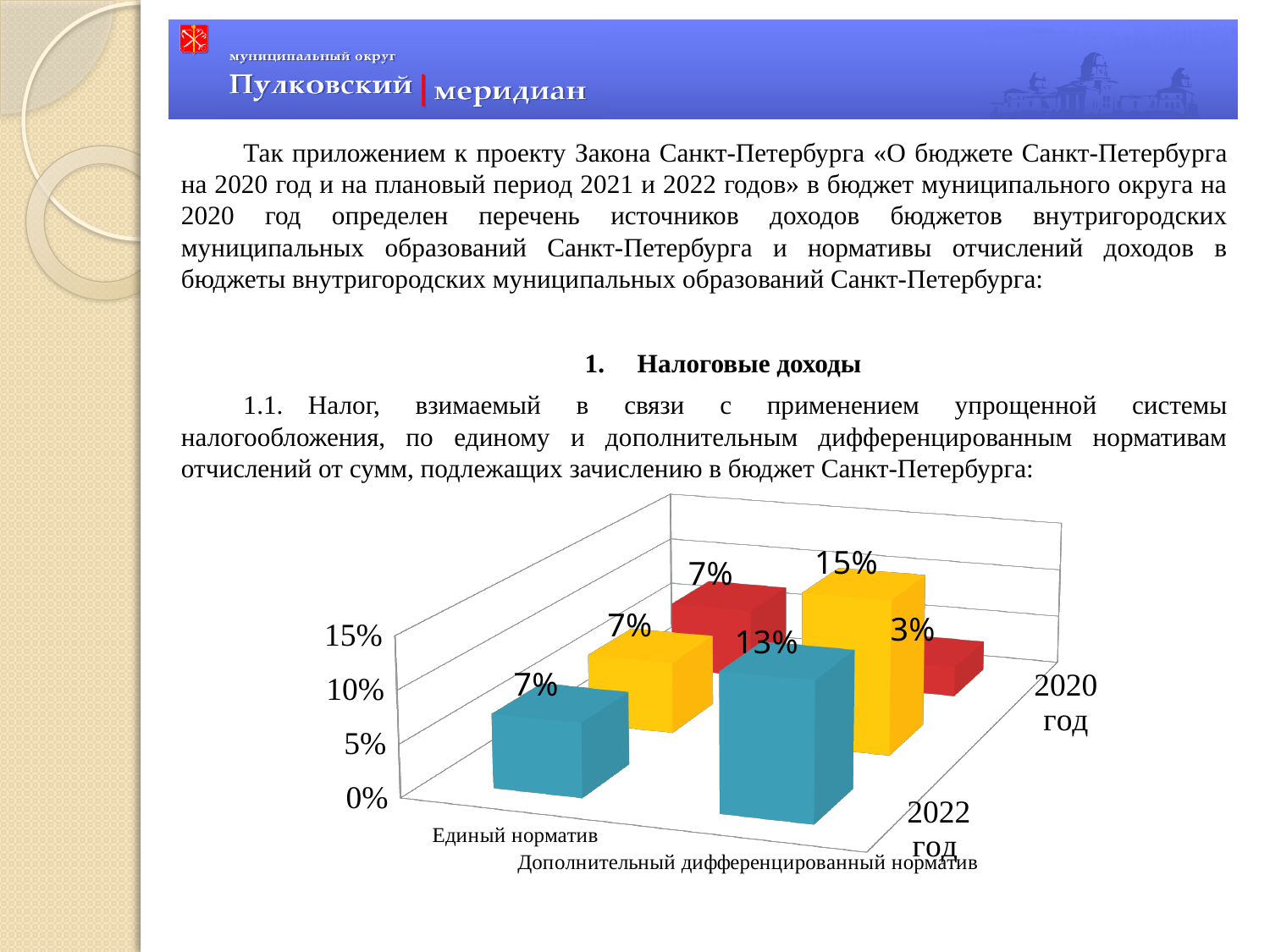
What is the highest value labelled on the chart? 15% In 2022 год, what is the difference between Дополнительный дифференцированный норматив and Единый норматив? 6% What is the value for Дополнительный дифференцированный норматив in 2022 год? 13% What is the highest tick shown on the vertical axis of the chart? 15% What is the value for Единый норматив in 2020 год? 7% What is the lowest value labelled on the chart? 3% What is the value for Единый норматив in 2022 год? 7% What is the value for Дополнительный дифференцированный норматив in 2020 год? 3% Is the value for Дополнительный дифференцированный норматив in 2022 год greater or less than 10%? greater How many categories are shown along the horizontal axis of the chart? 2 What kind of chart is shown on the slide? bar chart In 2020 год, which is larger: Единый норматив or Дополнительный дифференцированный норматив? Единый норматив